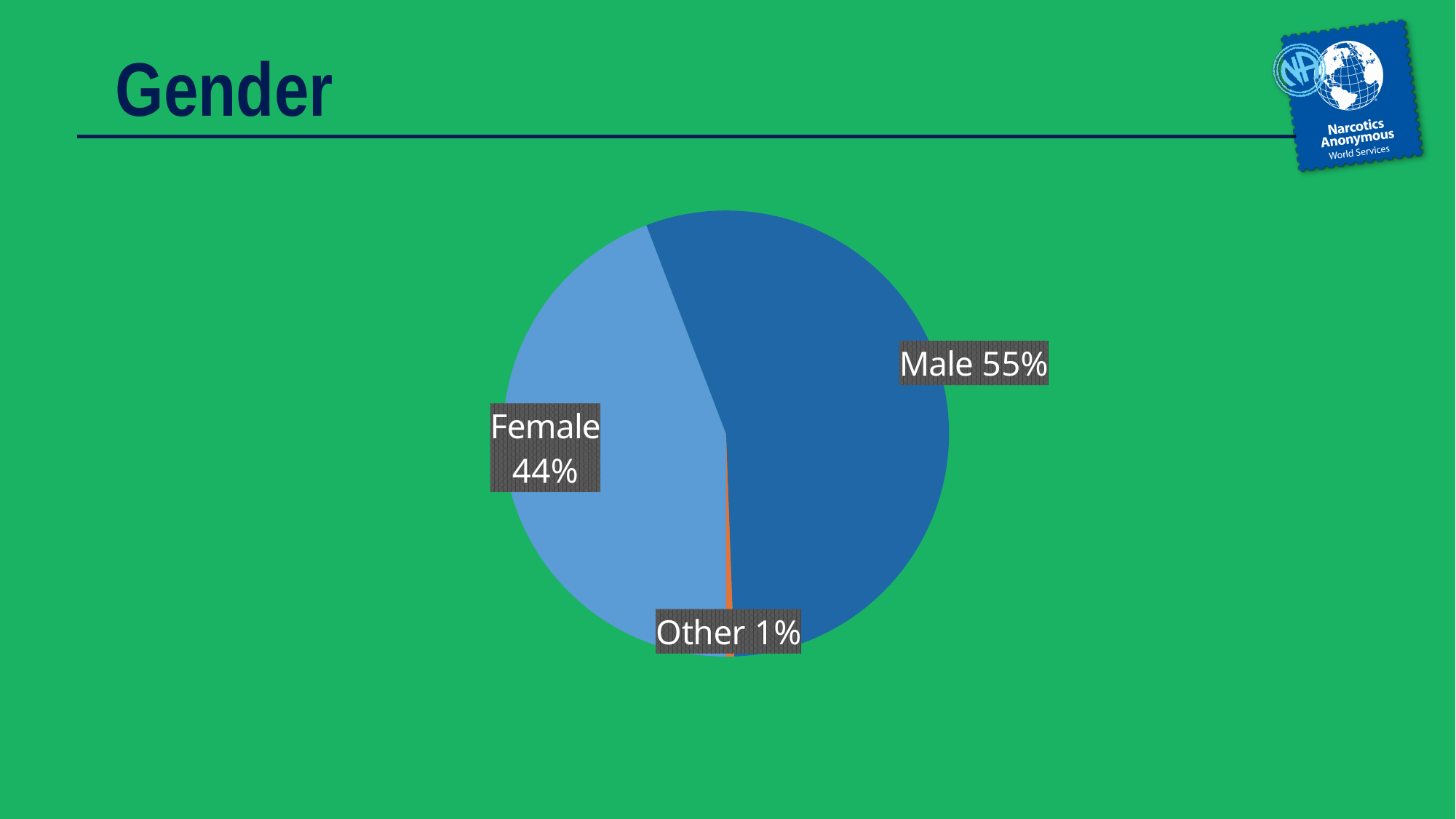
Which category has the smallest share of the pie chart? Other What is the difference in percentage points between the Male and Female shares? 11 What is the combined share of the Male and Female slices? 99% What is the title of the slide? Gender Which category has the largest share of the pie chart? Male Which is larger, the Female share or the Other share? Female What percentage of the pie chart is Male? 55% What kind of chart is shown on the slide? Pie chart What colour is the Other slice of the pie chart? Orange How many categories are shown in the pie chart? 3 What percentage of the pie chart is Other? 1% What percentage of the pie chart is Female? 44%